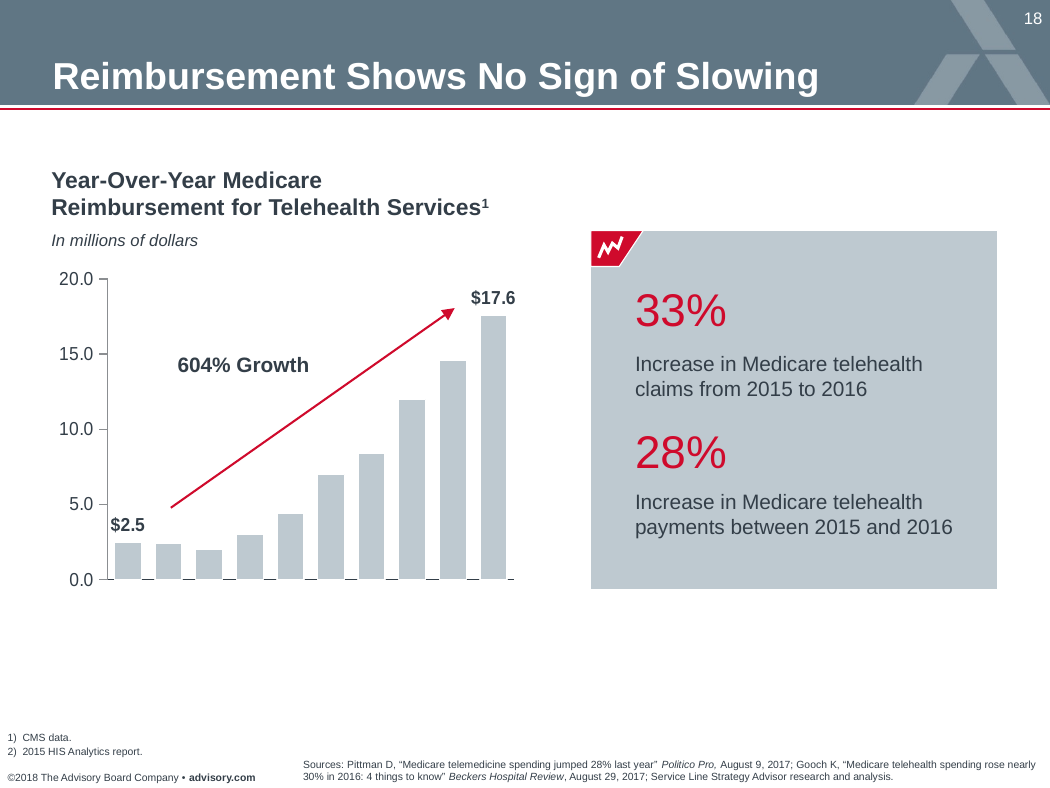
Is the value for the seventh bar from the left greater or less than 5.0? greater Do the values generally rise or fall from left to right along the x axis? Rise What growth percentage is annotated on the chart? 604% Growth What is the value labeled on the first (leftmost) bar? $2.5 What is the value labeled on the last (rightmost) bar? $17.6 Is the value for the ninth bar from the left greater or less than 15.0? less In what units are the chart values expressed? In millions of dollars What is the difference between the last bar ($17.6) and the first bar ($2.5)? $15.1 Which bar is the highest in the chart? The last (rightmost) bar How many bars are plotted in the chart? 10 Which bar is the lowest in the chart? The third bar from the left What kind of chart is shown on the slide? Bar chart